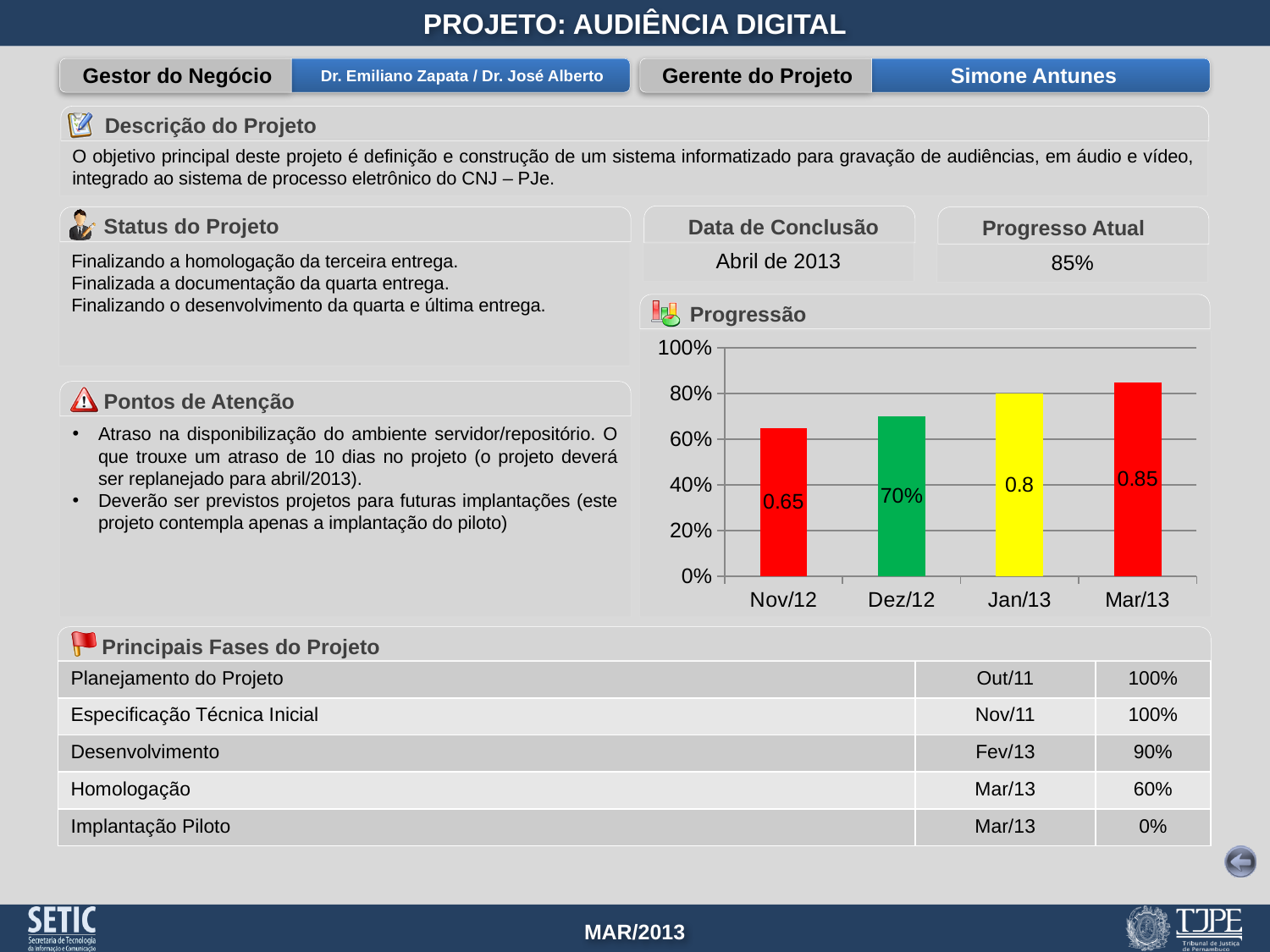
Do the values in the Progressão chart rise or fall from Nov/12 to Mar/13? Rise How many months are plotted in the Progressão chart? 4 Which month has the highest bar in the Progressão chart? Mar/13 What is the value shown for Mar/13 in the Progressão chart? 0.85 What kind of chart is the Progressão chart? Bar chart What is the value shown for Nov/12 in the Progressão chart? 0.65 Which month has the lowest bar in the Progressão chart? Nov/12 In the Progressão chart, which is larger, the value for Dez/12 or the value for Jan/13? Jan/13 What is the value shown for Dez/12 in the Progressão chart? 70% In the Progressão chart, is the value for Mar/13 greater or less than 80%? greater In the Progressão chart, what is the difference between the values for Mar/13 and Jan/13? 0.05 What is the value shown for Jan/13 in the Progressão chart? 0.8